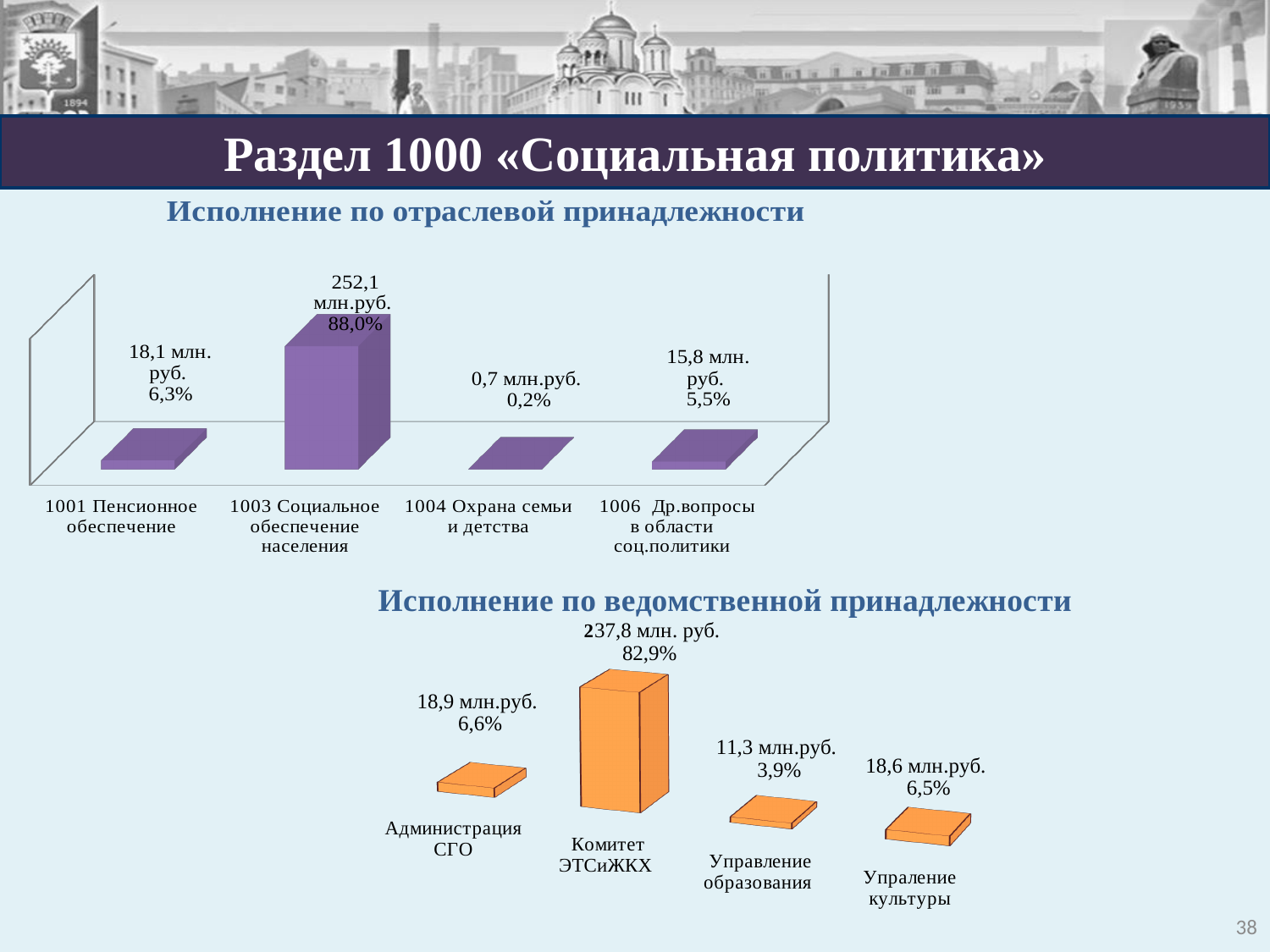
In the chart titled «Исполнение по ведомственной принадлежности», which category has the lowest value? Управление образования In the chart titled «Исполнение по отраслевой принадлежности», what is the value for «1003 Социальное обеспечение населения»? 252,1 млн.руб. In the chart titled «Исполнение по отраслевой принадлежности», what percentage is shown for «1001 Пенсионное обеспечение»? 6,3% In the chart titled «Исполнение по отраслевой принадлежности», what is the difference in млн.руб. between «1001 Пенсионное обеспечение» and «1006 Др.вопросы в области соц.политики»? 2,3 млн.руб. In the chart titled «Исполнение по отраслевой принадлежности», which category has the highest value? 1003 Социальное обеспечение населения In the chart titled «Исполнение по отраслевой принадлежности», which category has the lowest value? 1004 Охрана семьи и детства In the chart titled «Исполнение по ведомственной принадлежности», which is larger: «Администрация СГО» or «Управление образования»? Администрация СГО In the chart titled «Исполнение по ведомственной принадлежности», what percentage is shown for «Управление образования»? 3,9% How many categories are shown in the chart titled «Исполнение по отраслевой принадлежности»? 4 What colour are the bars in the chart titled «Исполнение по отраслевой принадлежности»? Purple In the chart titled «Исполнение по ведомственной принадлежности», what is the value for «Комитет ЭТСиЖКХ»? 237,8 млн. руб. What type of chart is the one titled «Исполнение по ведомственной принадлежности»? Bar chart